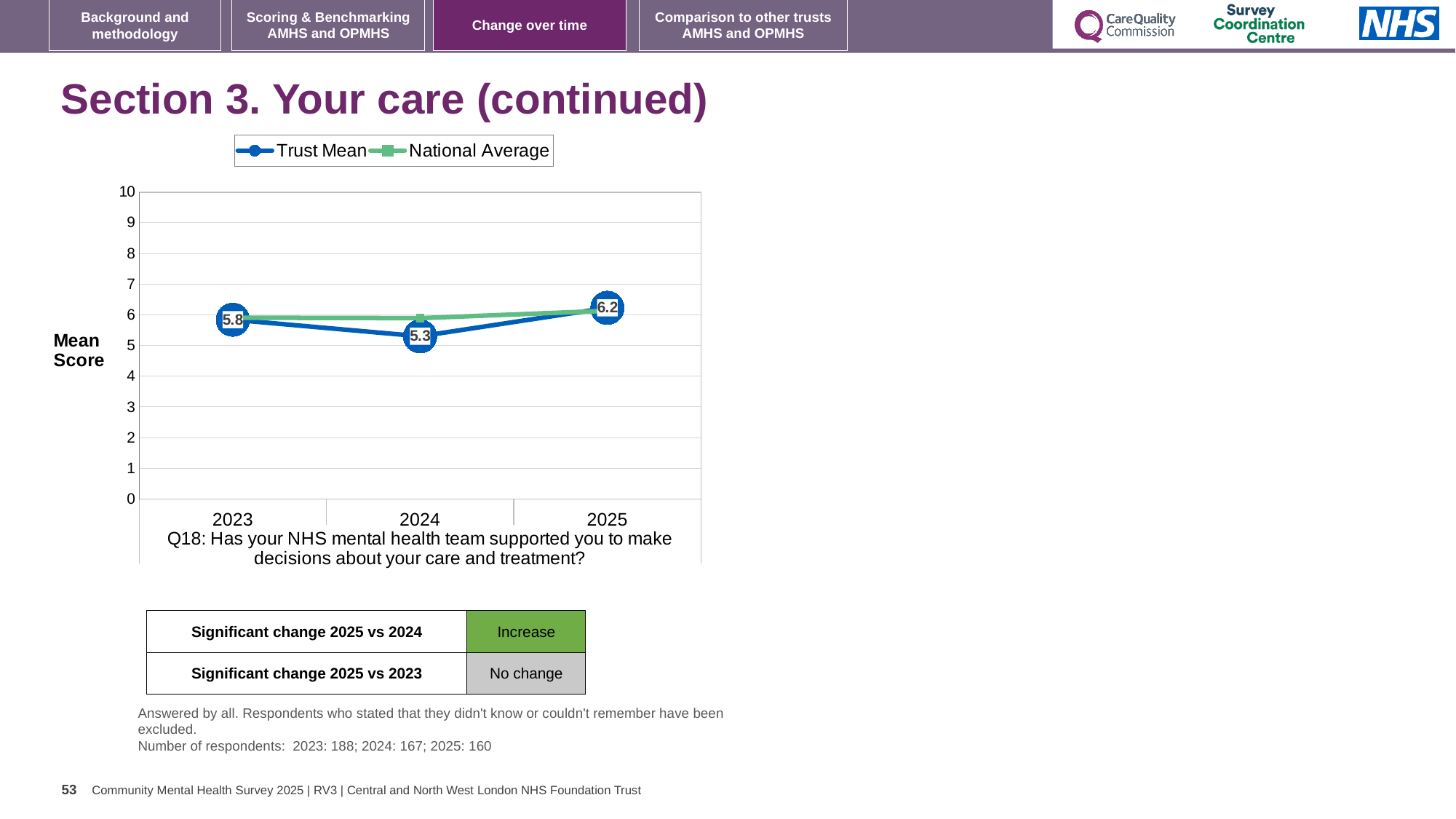
In which year is the Trust Mean score lowest? 2024 What is the Trust Mean score for 2023? 5.8 What is the difference between the Trust Mean scores for 2023 and 2024? 0.5 What is the Trust Mean score for 2024? 5.3 What is the Trust Mean score for 2025? 6.2 Is the National Average value for 2024 greater or less than 5? greater What is the difference between the Trust Mean scores for 2025 and 2024? 0.9 How many years are plotted on the x axis? 3 How many series does the legend list? 2 In 2024, which is larger: the Trust Mean or the National Average? National Average What kind of chart is shown on the slide? Line chart In which year is the Trust Mean score highest? 2025